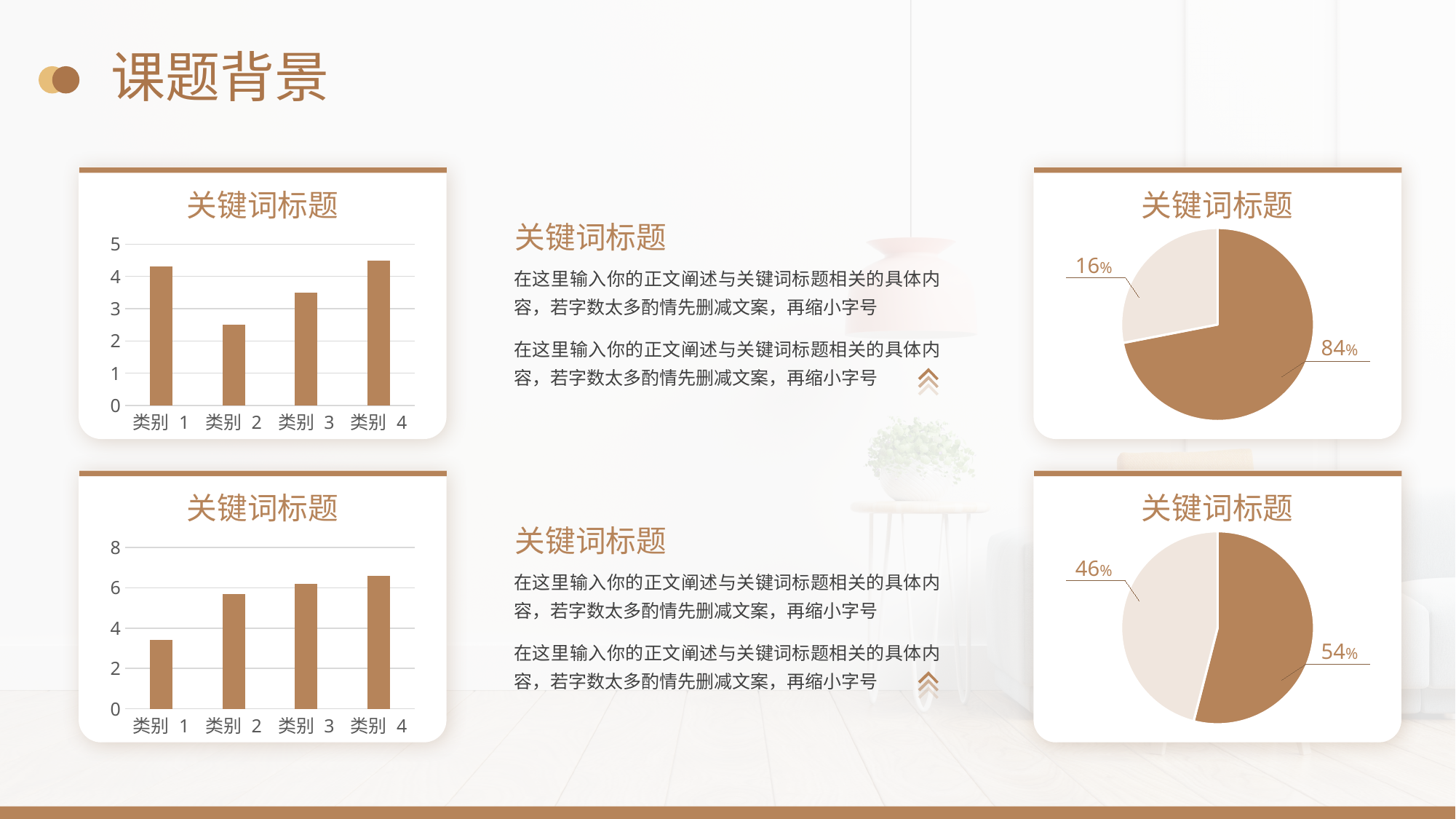
In the bottom-left bar chart, which is larger, the value for 类别 1 or 类别 3? 类别 3 What kind of chart is the top-left chart? bar chart How many categories are shown in the bottom-left bar chart? 4 In the bottom-left bar chart, do the values rise or fall from 类别 1 to 类别 4? rise What kind of chart is the top-right chart? pie chart In the top-left bar chart, is the value for 类别 2 greater or less than 3? less In the bottom-right pie chart, what is the difference between the two slices? 8% In the top-right pie chart, what share does the larger slice have? 84% In the top-left bar chart, which category has the lowest value? 类别 2 In the bottom-left bar chart, is the value for 类别 2 greater or less than 6? less In the bottom-left bar chart, which category has the lowest value? 类别 1 In the top-left bar chart, is the value for 类别 1 greater or less than 4? greater